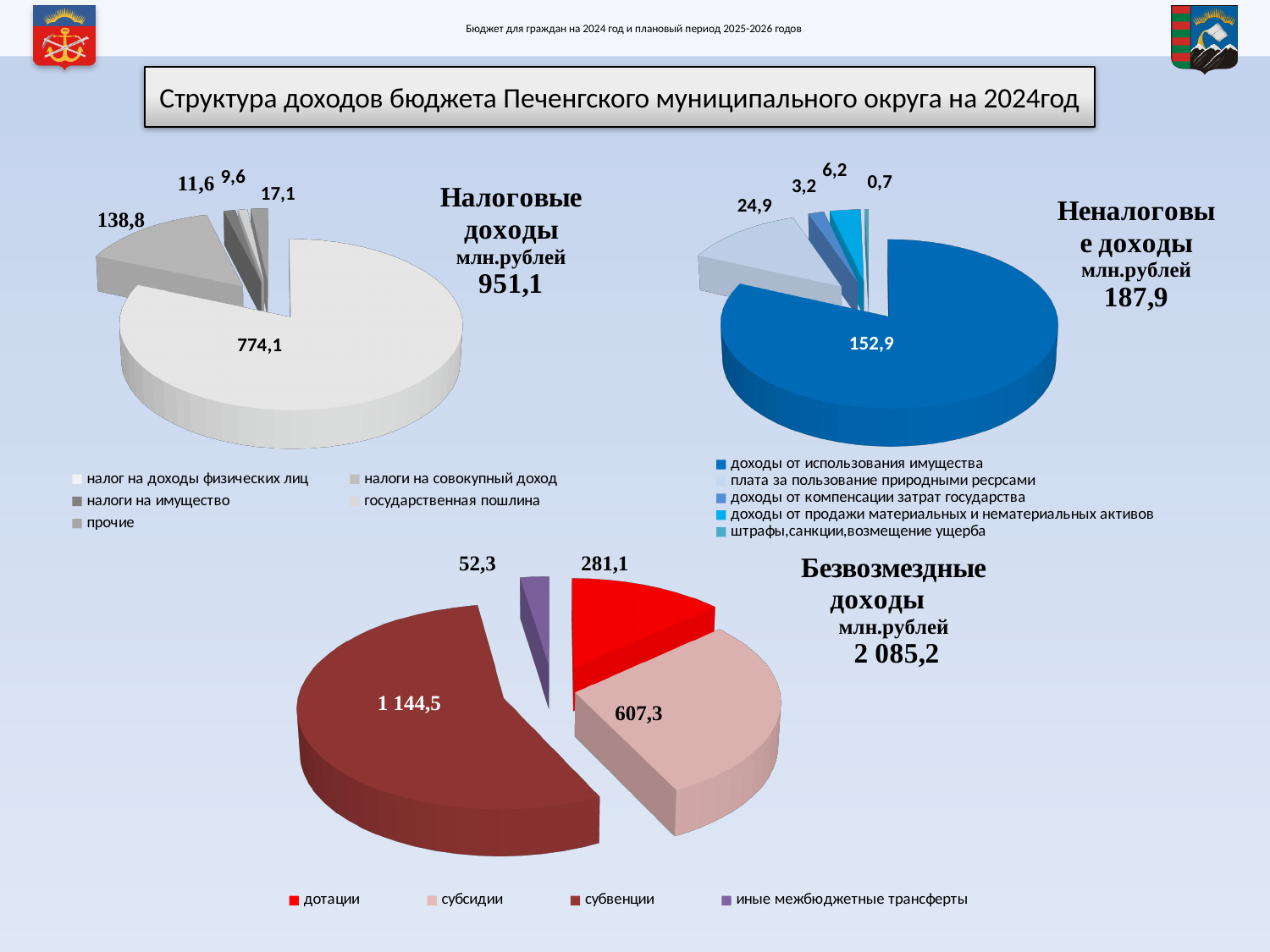
In the 'Безвозмездные доходы' pie chart, which is larger: дотации or иные межбюджетные трансферты? дотации In the 'Безвозмездные доходы' pie chart, what is the difference between субвенции and субсидии? 537,2 In the 'Безвозмездные доходы' pie chart, which category is the largest? субвенции In the 'Неналоговые доходы' pie chart, what is the smallest value shown? 0,7 In the 'Налоговые доходы' pie chart, what is the value for налог на доходы физических лиц? 774,1 In the 'Налоговые доходы' pie chart, what is the total shown for tax revenues in млн.рублей? 951,1 In the 'Безвозмездные доходы' pie chart, what is the value for субсидии? 607,3 In the 'Неналоговые доходы' pie chart, how many slices are there? 5 What type of chart is used for 'Налоговые доходы'? pie chart In the 'Неналоговые доходы' pie chart, what is the value for доходы от использования имущества? 152,9 In the 'Налоговые доходы' pie chart, what is the value for налоги на совокупный доход? 138,8 How many categories does the legend of the 'Безвозмездные доходы' chart list? 4